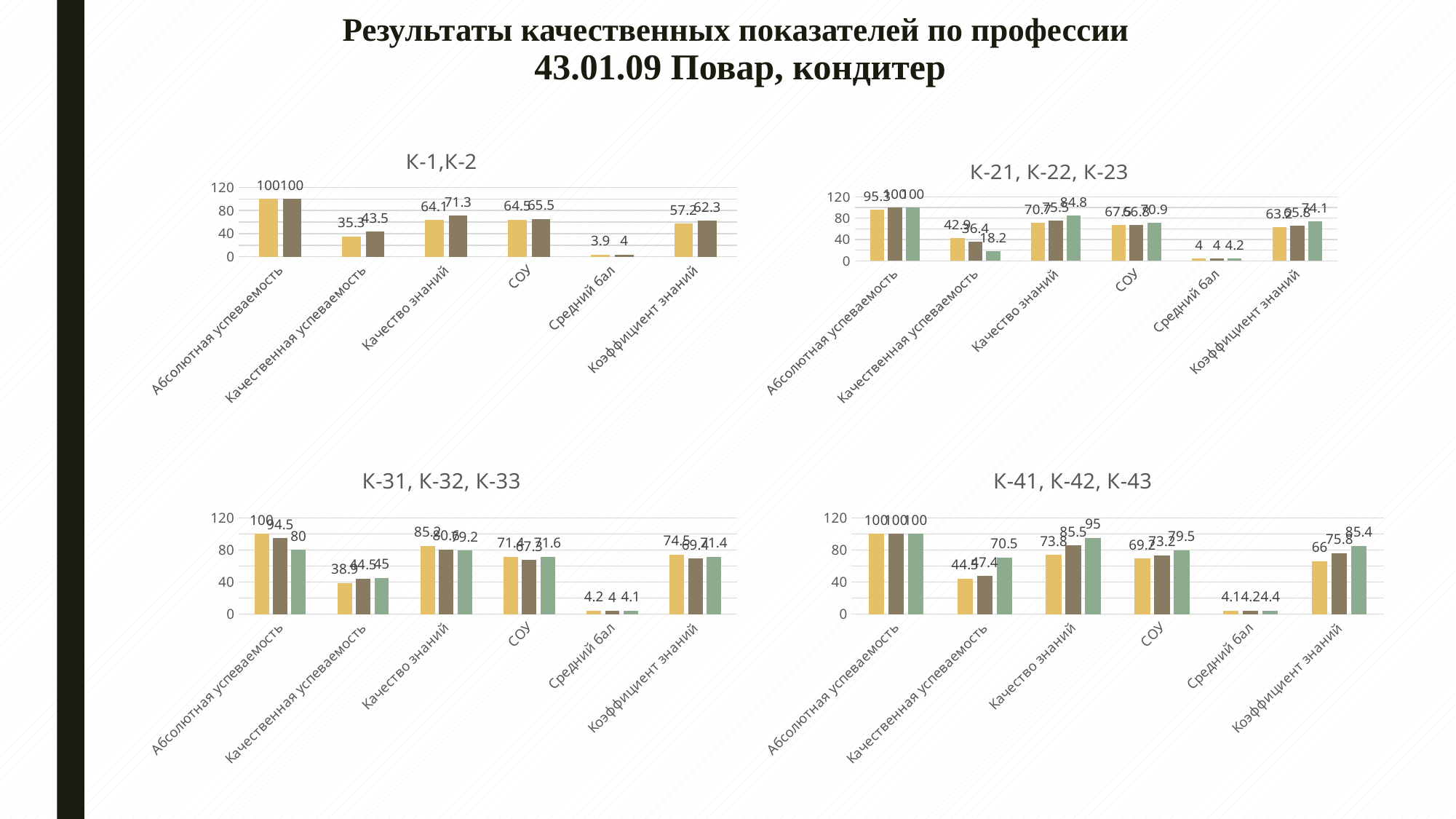
What kind of chart is the chart titled К-1,К-2? bar chart In the chart titled К-41, К-42, К-43, which category has the highest values? Абсолютная успеваемость In the chart titled К-31, К-32, К-33, what is the value of the third (green) bar for Абсолютная успеваемость? 80 In the chart titled К-31, К-32, К-33, how many categories are shown on the x axis? 6 In the chart titled К-1,К-2, what is the value of the second (brown) bar for Качество знаний? 71.3 In the chart titled К-21, К-22, К-23, is the value of the third (green) bar for Качественная успеваемость greater or less than 40? less How many charts are on the slide? 4 In the chart titled К-21, К-22, К-23, what is the value of the third (green) bar for Качественная успеваемость? 18.2 In the chart titled К-41, К-42, К-43, what is the value of the third (green) bar for Качество знаний? 95 In the chart titled К-31, К-32, К-33, which is larger for Абсолютная успеваемость: the first (yellow) bar or the third (green) bar? the first (yellow) bar In the chart titled К-41, К-42, К-43, which category has the lowest values? Средний бал In the chart titled К-1,К-2, what is the difference between the two bars for Качество знаний? 7.2